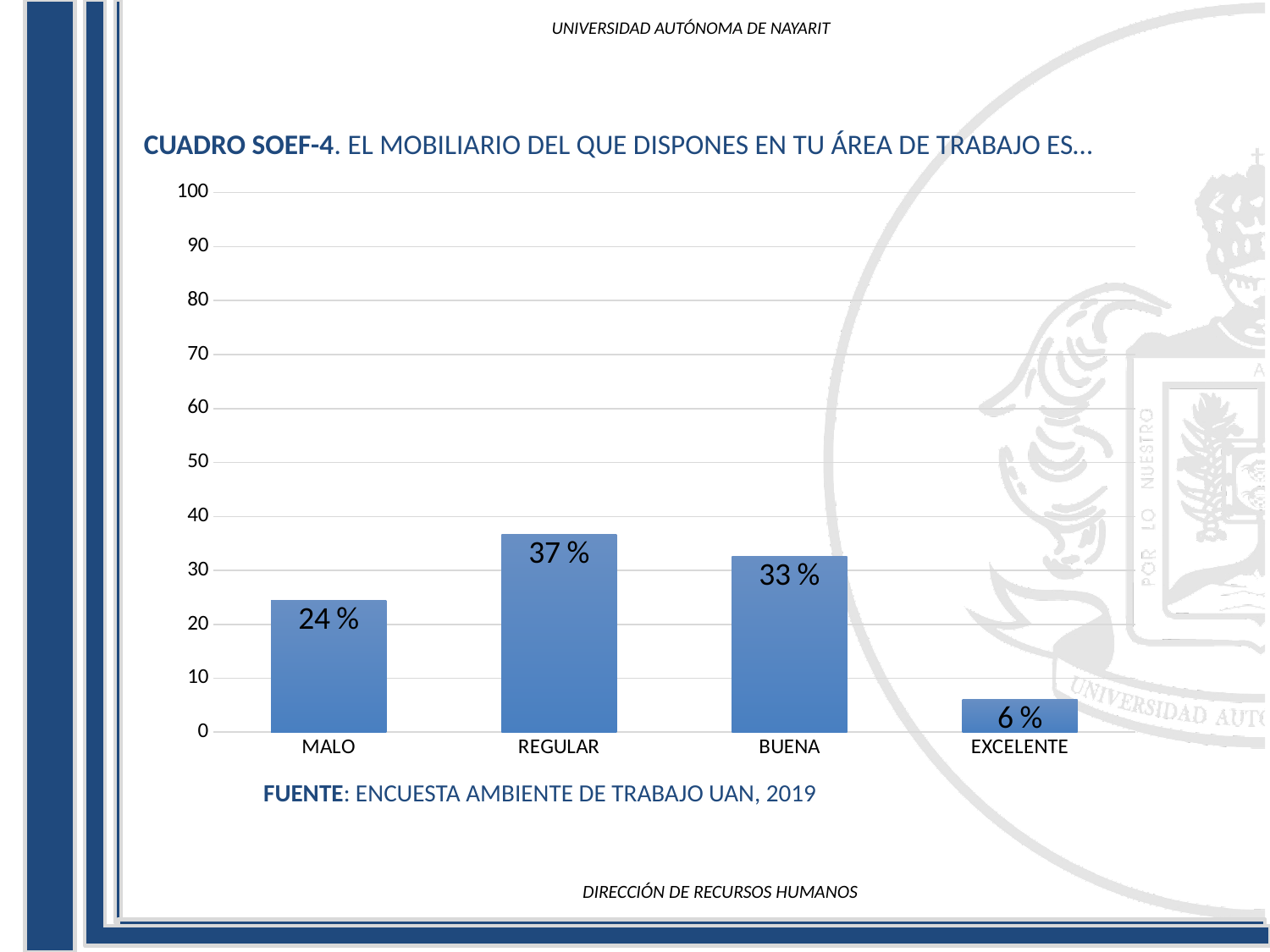
What is the value for MALO? 24 % What is the value for REGULAR? 37 % Which is larger, the value for MALO or the value for BUENA? BUENA What source is cited below the chart? ENCUESTA AMBIENTE DE TRABAJO UAN, 2019 What is the difference between the values for REGULAR and BUENA? 4 % Is the value for BUENA greater or less than 40? less What kind of chart is shown on the slide? bar chart What is the difference between the values for MALO and EXCELENTE? 18 % Which category has the highest value? REGULAR What is the value for EXCELENTE? 6 % Which category has the lowest value? EXCELENTE How many categories are shown on the x axis? 4